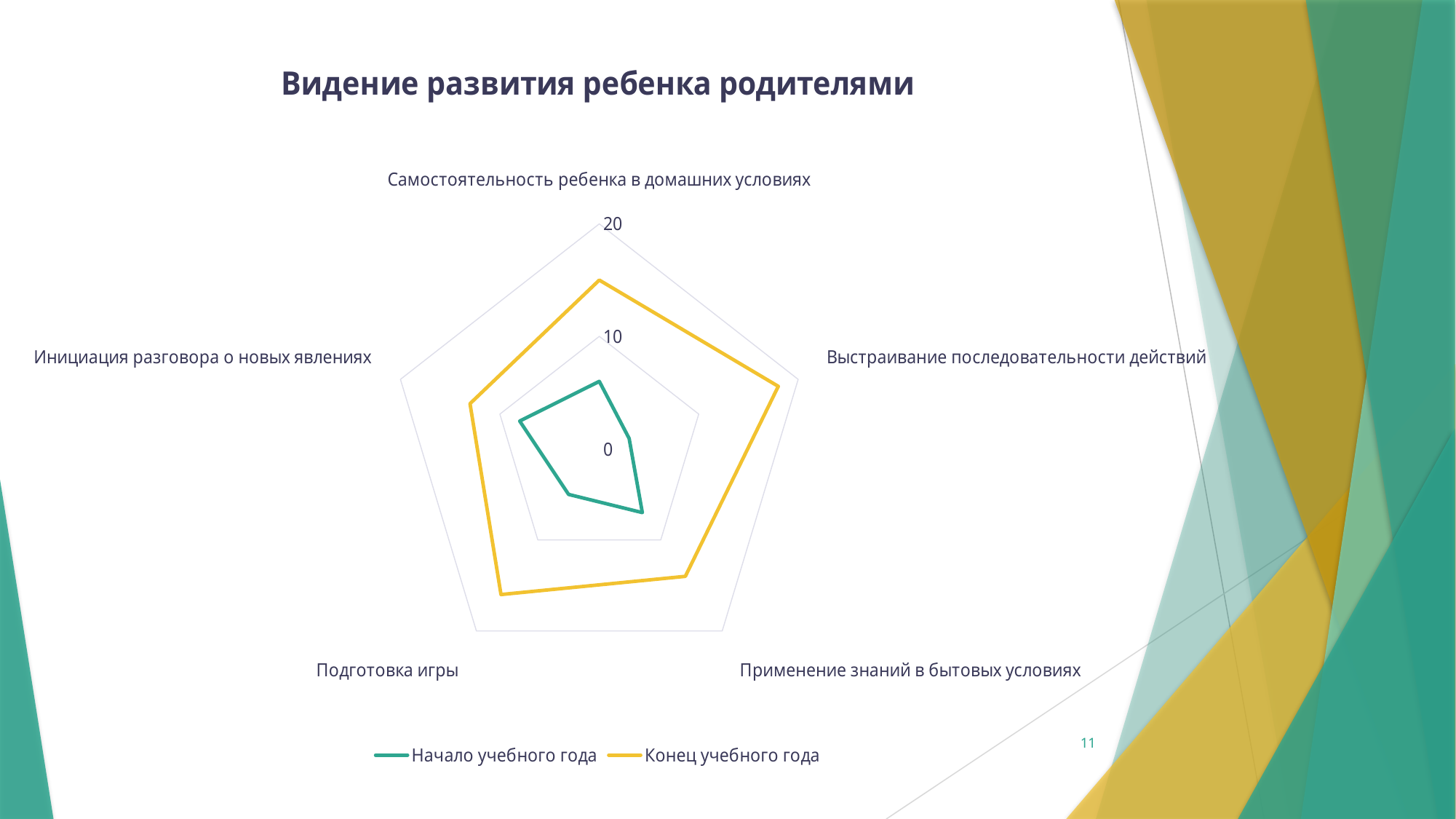
Is the value for Подготовка игры in the Начало учебного года series greater or less than 10? less Is the value for Самостоятельность ребенка в домашних условиях in the Конец учебного года series greater or less than 10? greater What kind of chart is shown on the slide? radar chart How many categories (axes) does the radar chart have? 5 In the Начало учебного года series, which category has the lowest value? Выстраивание последовательности действий For Применение знаний в бытовых условиях, which series has the larger value, Начало учебного года or Конец учебного года? Конец учебного года What is the title of the chart on the slide? Видение развития ребенка родителями How many series does the legend list? 2 In the Начало учебного года series, which category has the highest value? Инициация разговора о новых явлениях Is the value for Выстраивание последовательности действий in the Конец учебного года series greater or less than 20? less Which series is drawn in yellow according to the legend? Конец учебного года